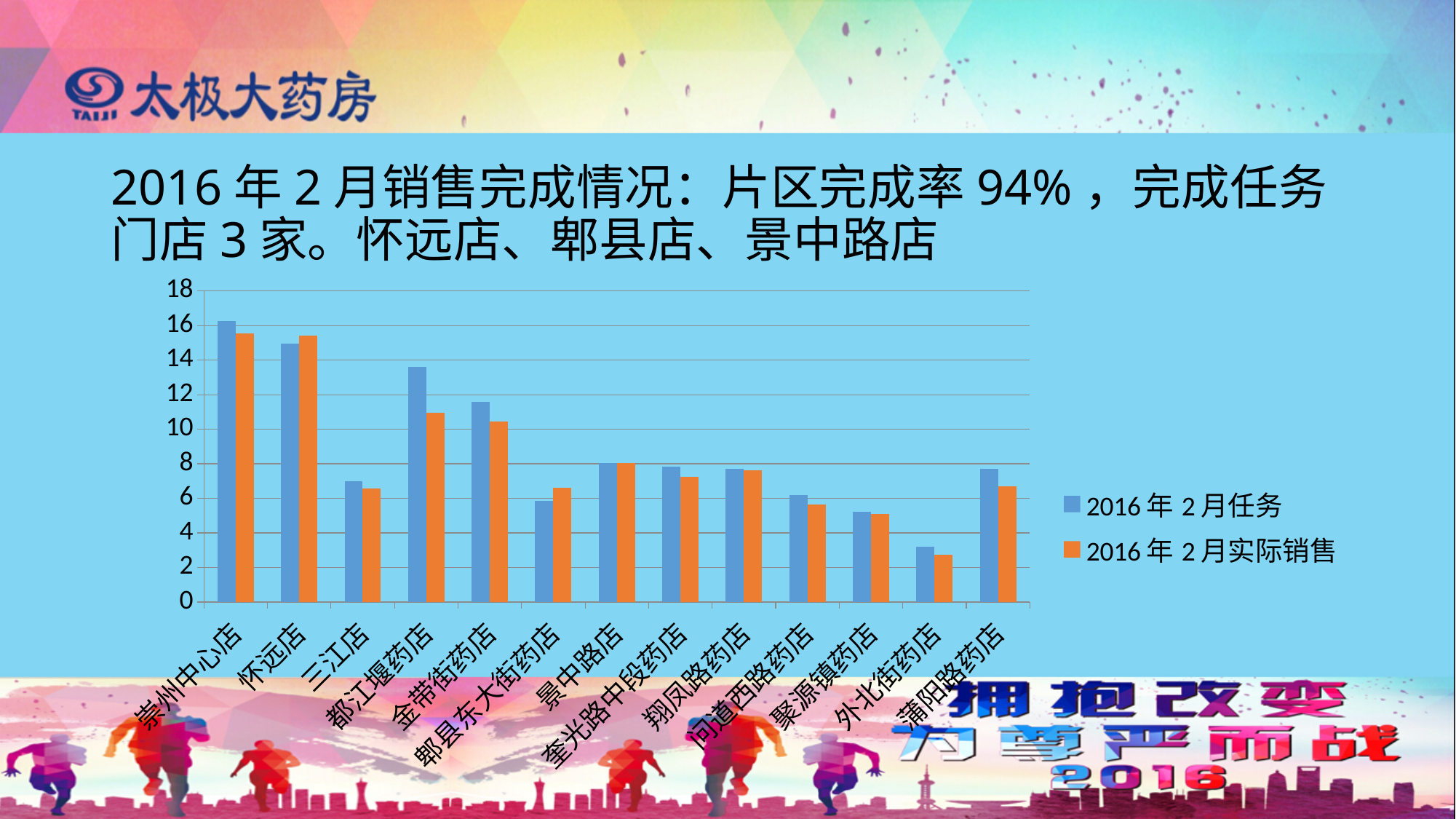
What kind of chart is shown on the slide? bar chart Is the 2016年2月实际销售 value for 外北街药店 greater or less than 4? less How many series does the chart legend list? 2 Which is larger: the 2016年2月任务 value for 三江店 or for 聚源镇药店? 三江店 Is the 2016年2月实际销售 value for 怀远店 greater or less than 14? greater Which store has the lowest 2016年2月实际销售 value? 外北街药店 Is the 2016年2月任务 value for 崇州中心店 greater or less than 14? greater Which store has the highest 2016年2月任务 value? 崇州中心店 For 都江堰药店, which is larger: the 2016年2月任务 value or the 2016年2月实际销售 value? 2016年2月任务 How many stores (categories) are shown on the x axis of the chart? 13 What are the two series named in the chart legend? 2016年2月任务 and 2016年2月实际销售